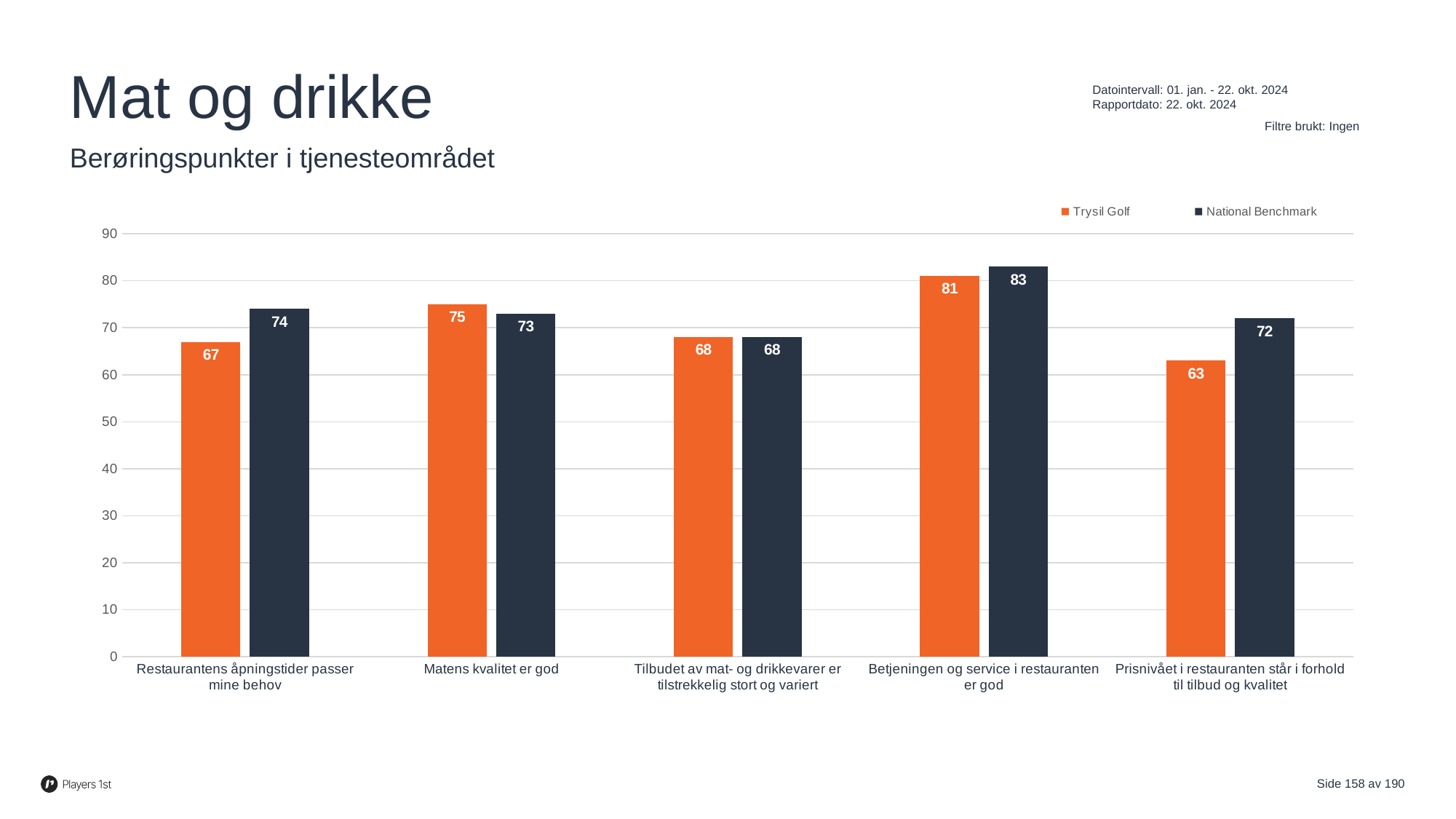
For "Matens kvalitet er god", which is larger: Trysil Golf or National Benchmark? Trysil Golf How many series does the legend list? 2 Is the National Benchmark value for "Betjeningen og service i restauranten er god" greater or less than 80? greater What is the Trysil Golf value for "Matens kvalitet er god"? 75 What is the Trysil Golf value for "Restaurantens åpningstider passer mine behov"? 67 Which category has the highest Trysil Golf value? Betjeningen og service i restauranten er god What is the difference between the National Benchmark and Trysil Golf values for "Prisnivået i restauranten står i forhold til tilbud og kvalitet"? 9 Which category has the lowest Trysil Golf value? Prisnivået i restauranten står i forhold til tilbud og kvalitet Which colour represents Trysil Golf in the chart? Orange What kind of chart is shown on the slide? Bar chart What is the National Benchmark value for "Prisnivået i restauranten står i forhold til tilbud og kvalitet"? 72 How many categories are shown on the x axis? 5